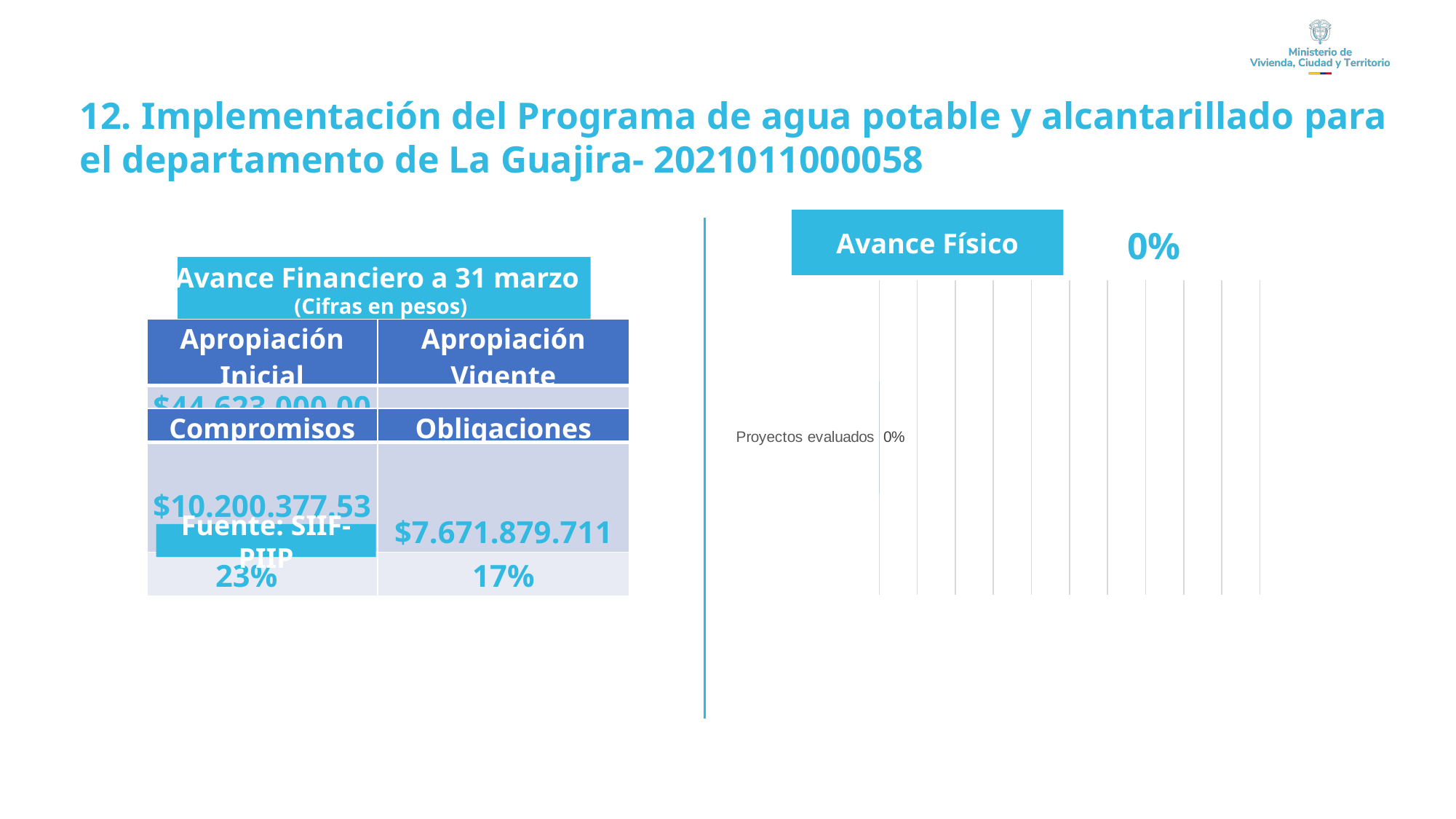
How many categories are plotted in the Avance Físico chart? 1 What kind of chart is the Avance Físico chart? bar chart What is the title of the chart on the right side of the slide? Avance Físico What is the value shown for Proyectos evaluados in the Avance Físico chart? 0% What is the category label shown on the Avance Físico chart? Proyectos evaluados